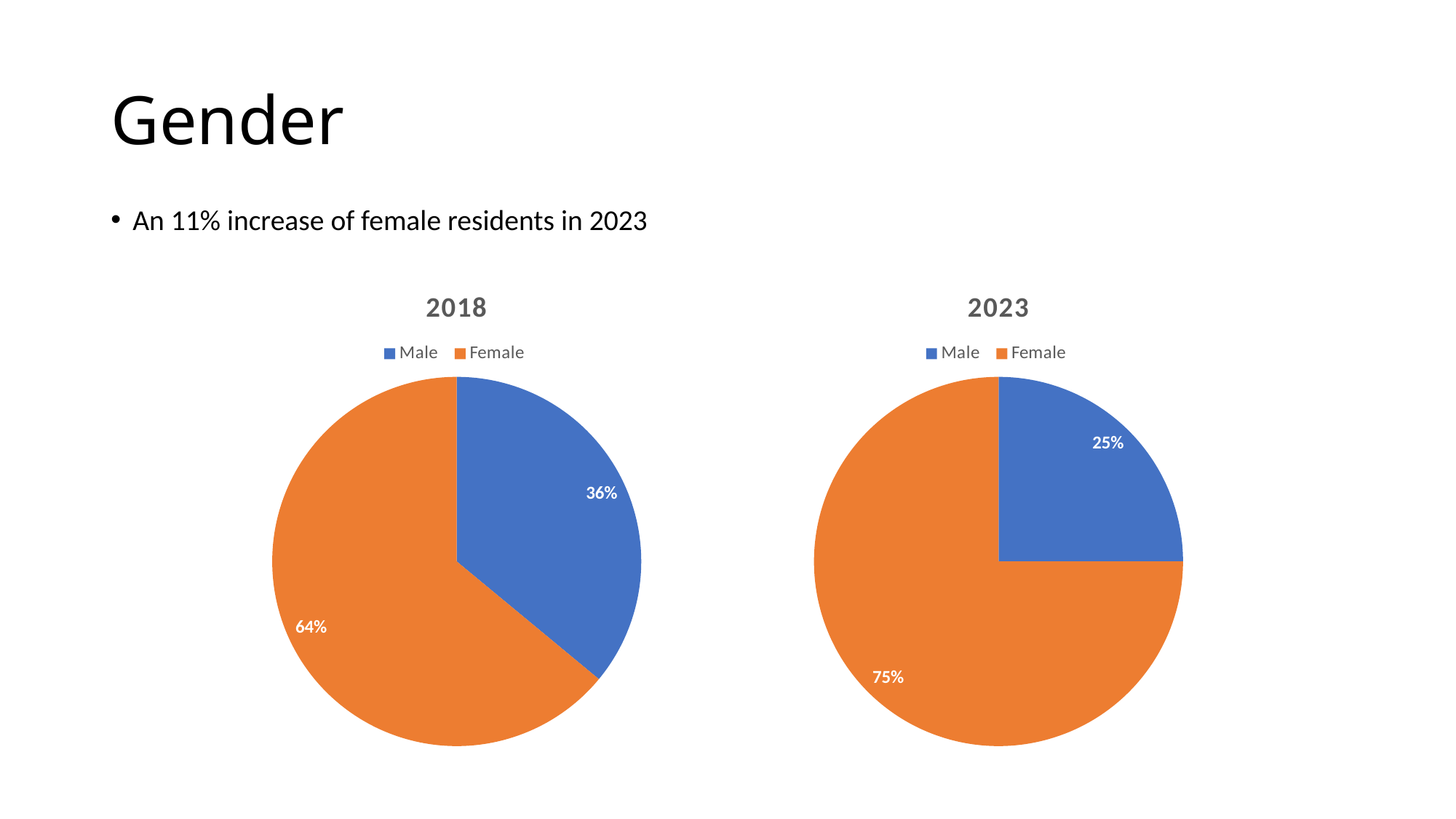
How many categories does the legend of the 2018 chart list? 2 In the 2018 pie chart, what is the difference between the Female and Male shares? 28% In the 2023 pie chart, what share is Male? 25% In the 2018 pie chart, what share is Female? 64% In the 2018 pie chart, which category has the largest slice? Female Is the Male share larger in the 2018 chart or the 2023 chart? 2018 In the 2023 pie chart, what share is Female? 75% In the 2023 pie chart, what colour is the Female slice? Orange In the 2023 pie chart, what is the difference between the Female and Male shares? 50% What kind of chart is the 2023 chart? Pie chart In the 2023 pie chart, which category has the smallest slice? Male